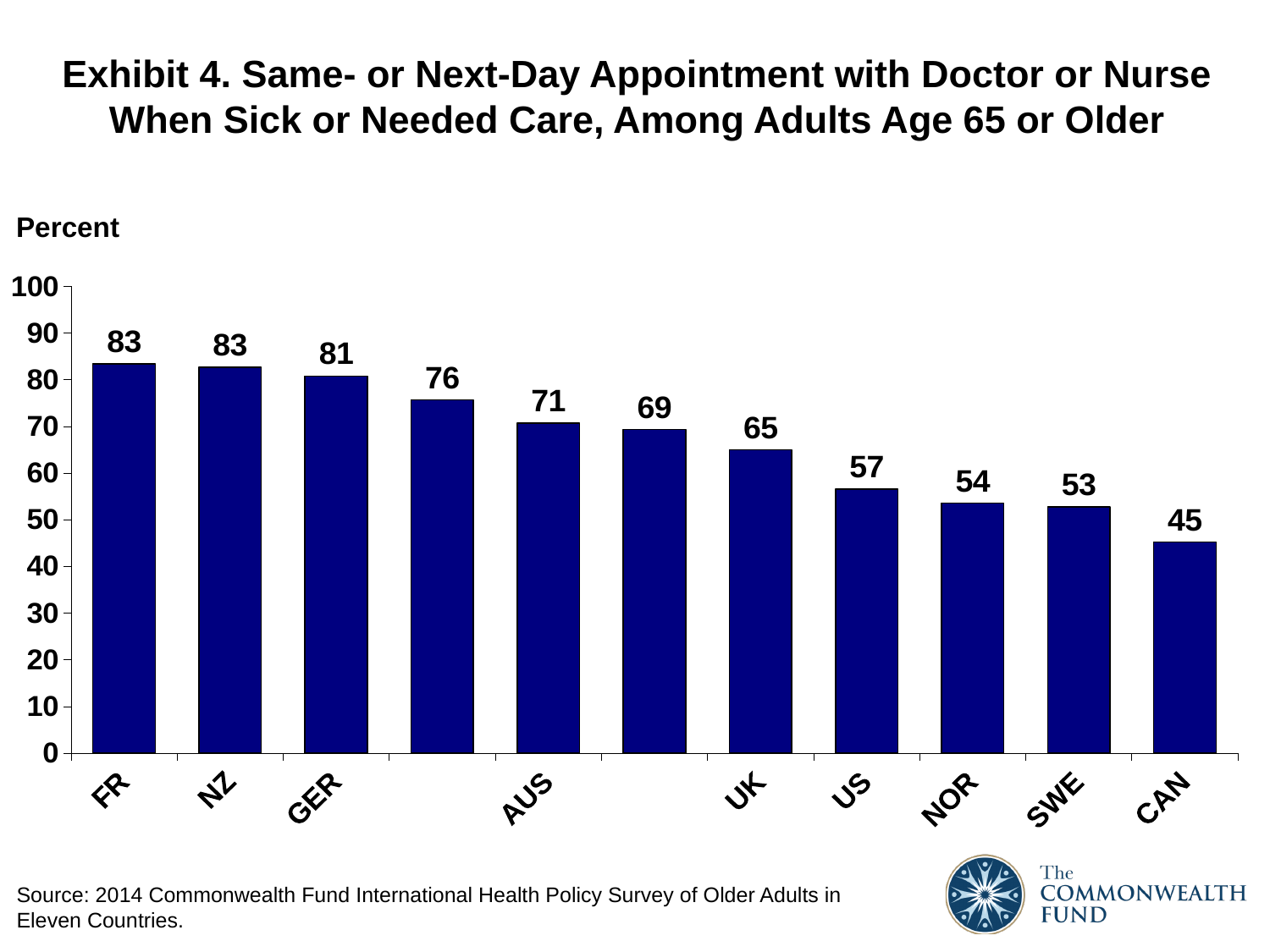
What is the value for CAN? 45 What is the label of the vertical axis? Percent What is the value for AUS? 71 How many bars are shown in the chart? 11 What kind of chart is shown on the slide? Bar chart What is the value for FR? 83 What is the value for GER? 81 What is the difference between the values for UK and CAN? 20 Which country has the lowest value? CAN What is the value for US? 57 Which is larger, the value for NOR or the value for SWE? NOR What is the difference between the values for NZ and US? 26